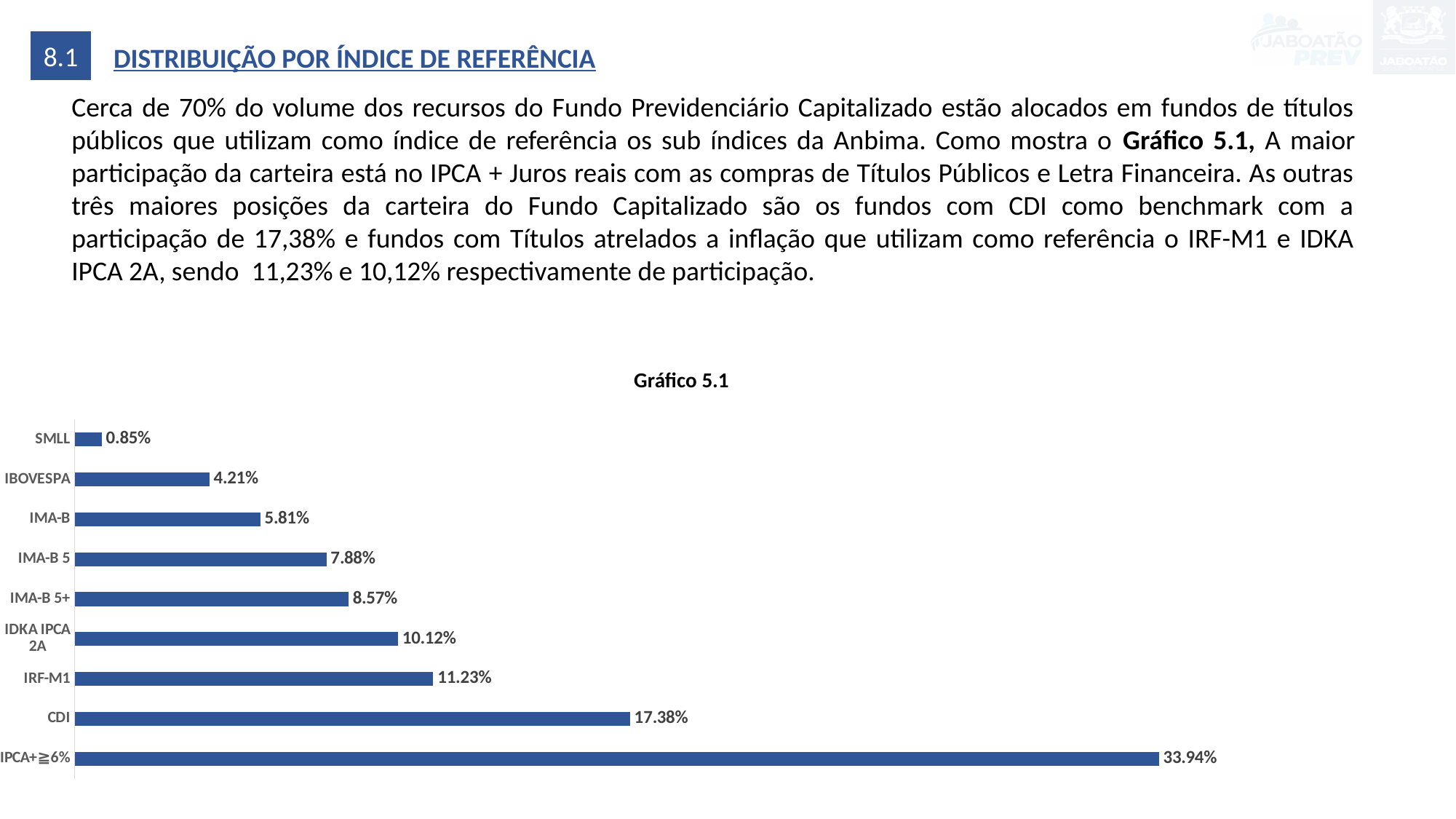
What is the value for IDKA IPCA 2A? 10.12% Which category has the highest value? IPCA+≧6% What is the difference between the values for CDI and IRF-M1? 6.15% What kind of chart is shown on the slide? Bar chart Which category has the lowest value? SMLL What is the value for CDI? 17.38% What is the value for SMLL? 0.85% What is the value for IMA-B 5+? 8.57% What is the title of the chart? Gráfico 5.1 What is the difference between the values for IMA-B 5 and IMA-B? 2.07% How many categories are shown in the chart? 9 Which is larger, the value for IBOVESPA or the value for IMA-B? IMA-B